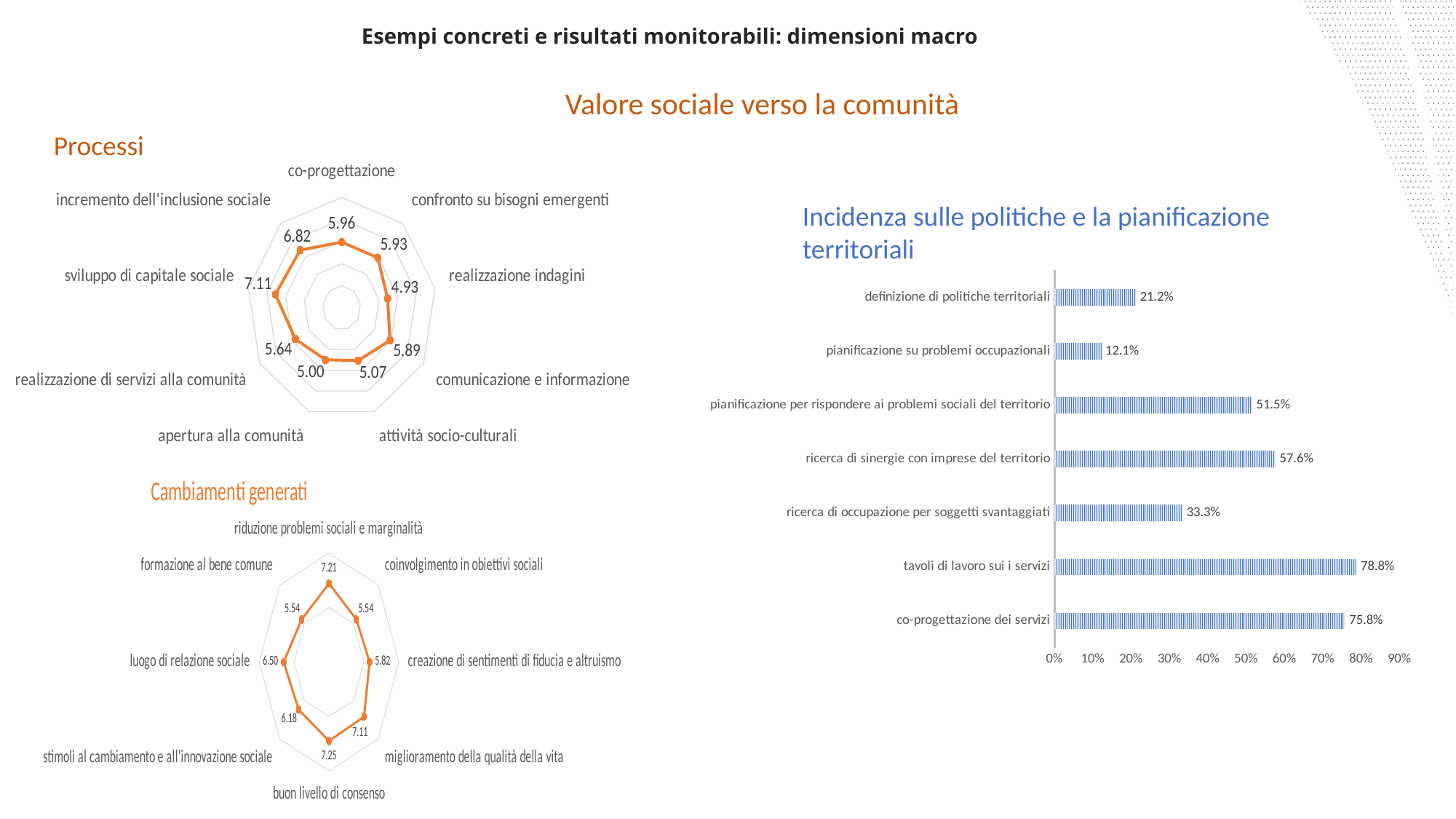
In the 'Processi' radar chart, what is the value for 'sviluppo di capitale sociale'? 7.11 In the 'Incidenza sulle politiche e la pianificazione territoriali' chart, which category has the highest value? tavoli di lavoro sui i servizi What kind of chart is 'Incidenza sulle politiche e la pianificazione territoriali'? bar chart In the 'Cambiamenti generati' radar chart, which is larger: 'luogo di relazione sociale' or 'creazione di sentimenti di fiducia e altruismo'? luogo di relazione sociale How many categories does the 'Cambiamenti generati' radar chart have? 8 In the 'Incidenza sulle politiche e la pianificazione territoriali' chart, what is the difference between 'tavoli di lavoro sui i servizi' and 'co-progettazione dei servizi'? 3.0% How many categories does the 'Incidenza sulle politiche e la pianificazione territoriali' bar chart show? 7 In the 'Processi' radar chart, which category has the lowest value? realizzazione indagini In the 'Incidenza sulle politiche e la pianificazione territoriali' chart, what is the value for 'ricerca di sinergie con imprese del territorio'? 57.6% In the 'Cambiamenti generati' radar chart, what is the value for 'buon livello di consenso'? 7.25 In the 'Processi' radar chart, what is the difference between 'incremento dell'inclusione sociale' and 'apertura alla comunità'? 1.82 How many categories does the 'Processi' radar chart have? 9